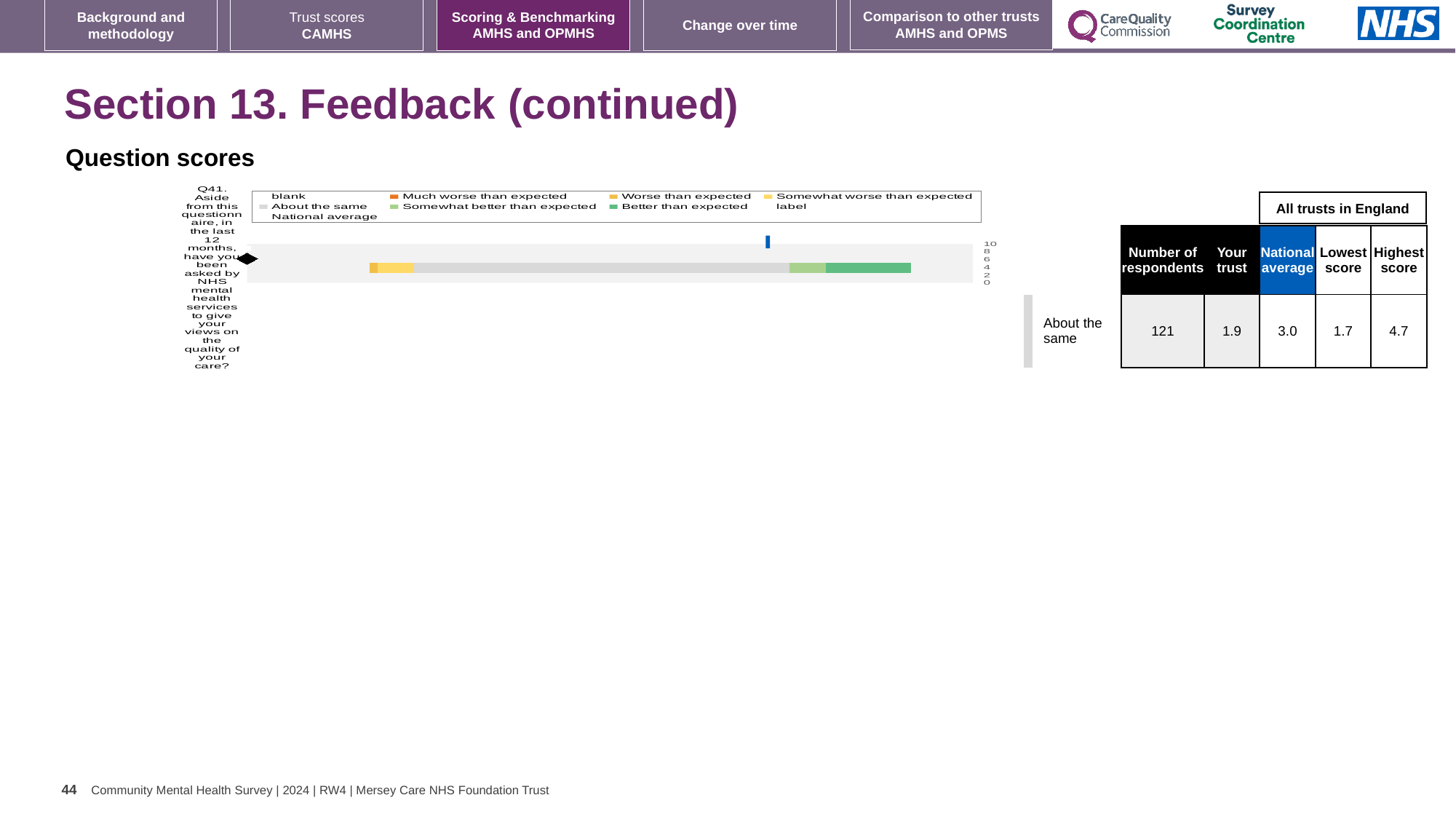
How many respondents are listed for Q41? 121 For Q41, how much higher is the national average than the 'Your trust' score? 1.1 What is the 'Your trust' score for Q41? 1.9 What is the lowest score among all trusts in England for Q41? 1.7 What is the national average score for Q41? 3.0 Which legend entry in the question scores chart is shown in dark orange? Much worse than expected What is the highest score among all trusts in England for Q41? 4.7 For Q41, is the 'Your trust' score higher or lower than the national average? lower What kind of chart is used to show the Q41 question score? bar chart For Q41, what is the difference between the highest score and the lowest score among all trusts in England? 3.0 How many questions are plotted in the question scores chart? 1 What benchmark category is shown for Q41 next to the chart? About the same